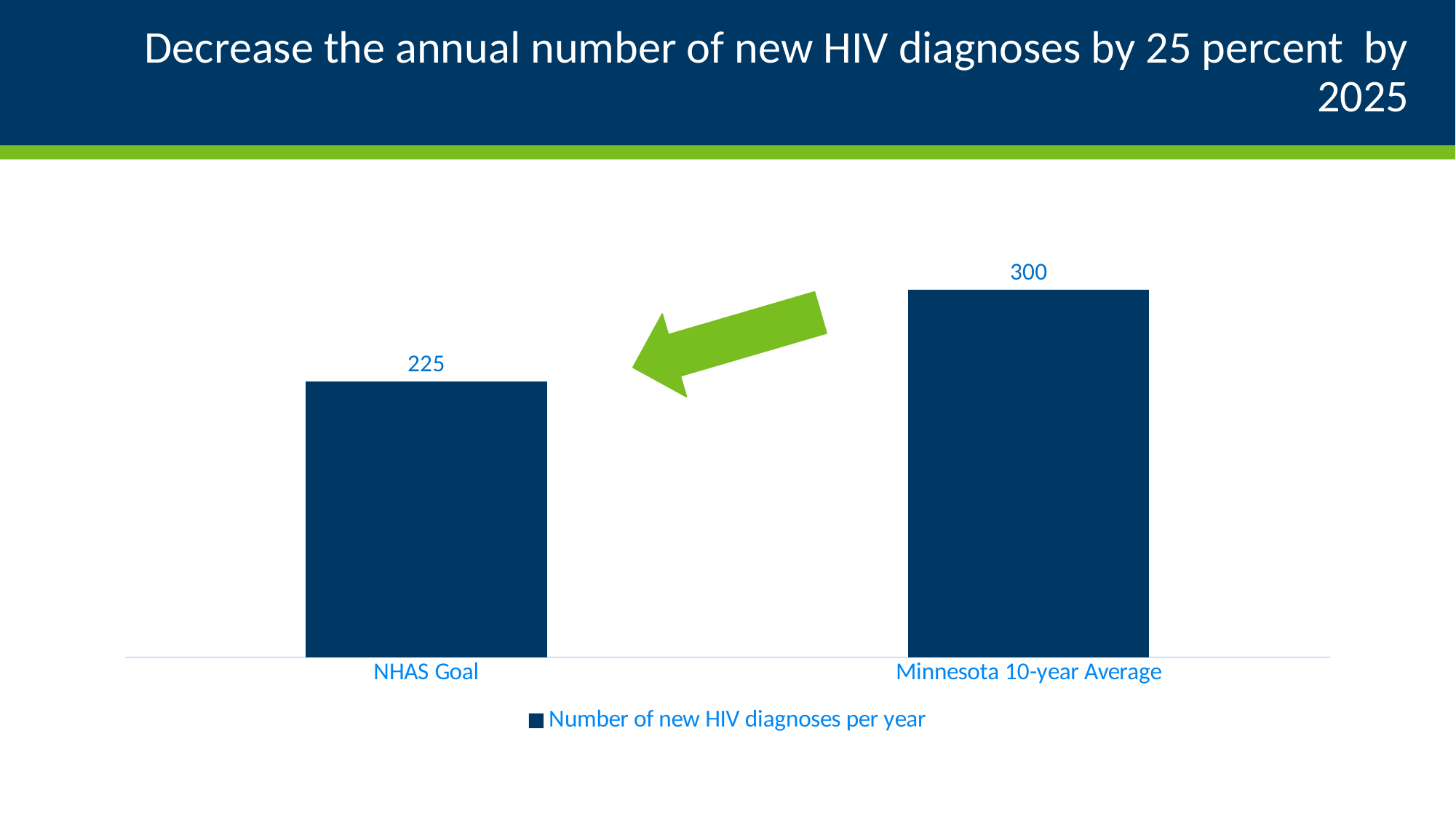
How many categories are shown in the chart? 2 Which category has the highest value? Minnesota 10-year Average What is the title of the slide? Decrease the annual number of new HIV diagnoses by 25 percent by 2025 What is the series name shown in the legend? Number of new HIV diagnoses per year What kind of chart is shown on the slide? Bar chart What is the difference between the Minnesota 10-year Average and the NHAS Goal? 75 Which category has the lowest value? NHAS Goal What is the value for Minnesota 10-year Average? 300 What is the value for NHAS Goal? 225 Which is larger, the NHAS Goal or the Minnesota 10-year Average? Minnesota 10-year Average How many series does the legend list? 1